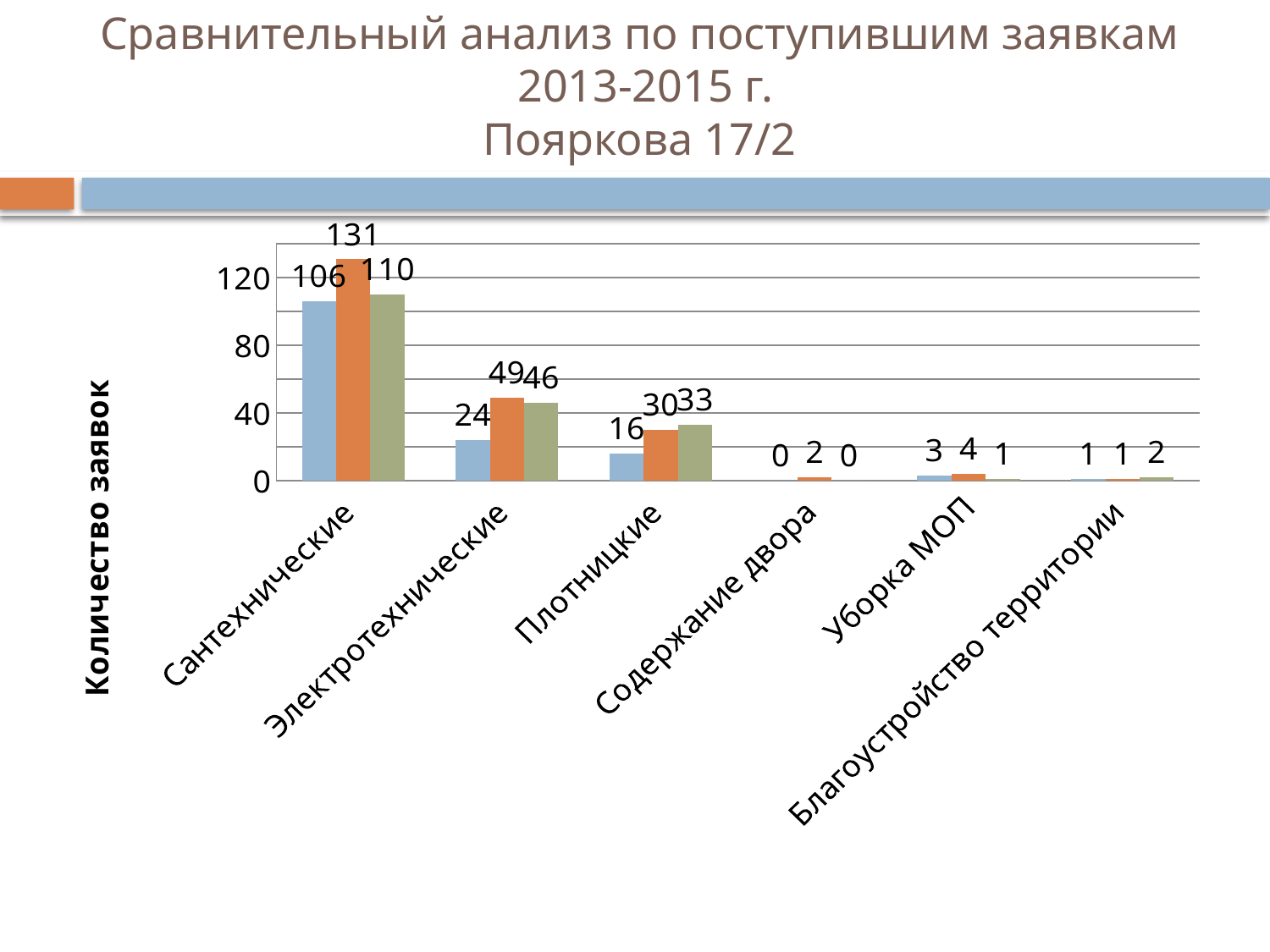
What is the value of the orange bar for Сантехнические? 131 What type of chart is shown on the slide? bar chart What is the difference between the orange bar and the green bar for Электротехнические? 3 How many categories are shown on the x axis of the chart? 6 What is the value of the blue bar for Электротехнические? 24 What is the value of the orange bar for Уборка МОП? 4 How many bars are shown for each category? 3 Which category has the highest orange bar? Сантехнические What is the label of the vertical axis? Количество заявок What is the difference between the orange bar and the blue bar for Сантехнические? 25 Which is larger for Плотницкие: the orange bar or the green bar? the green bar What is the value of the green bar for Плотницкие? 33